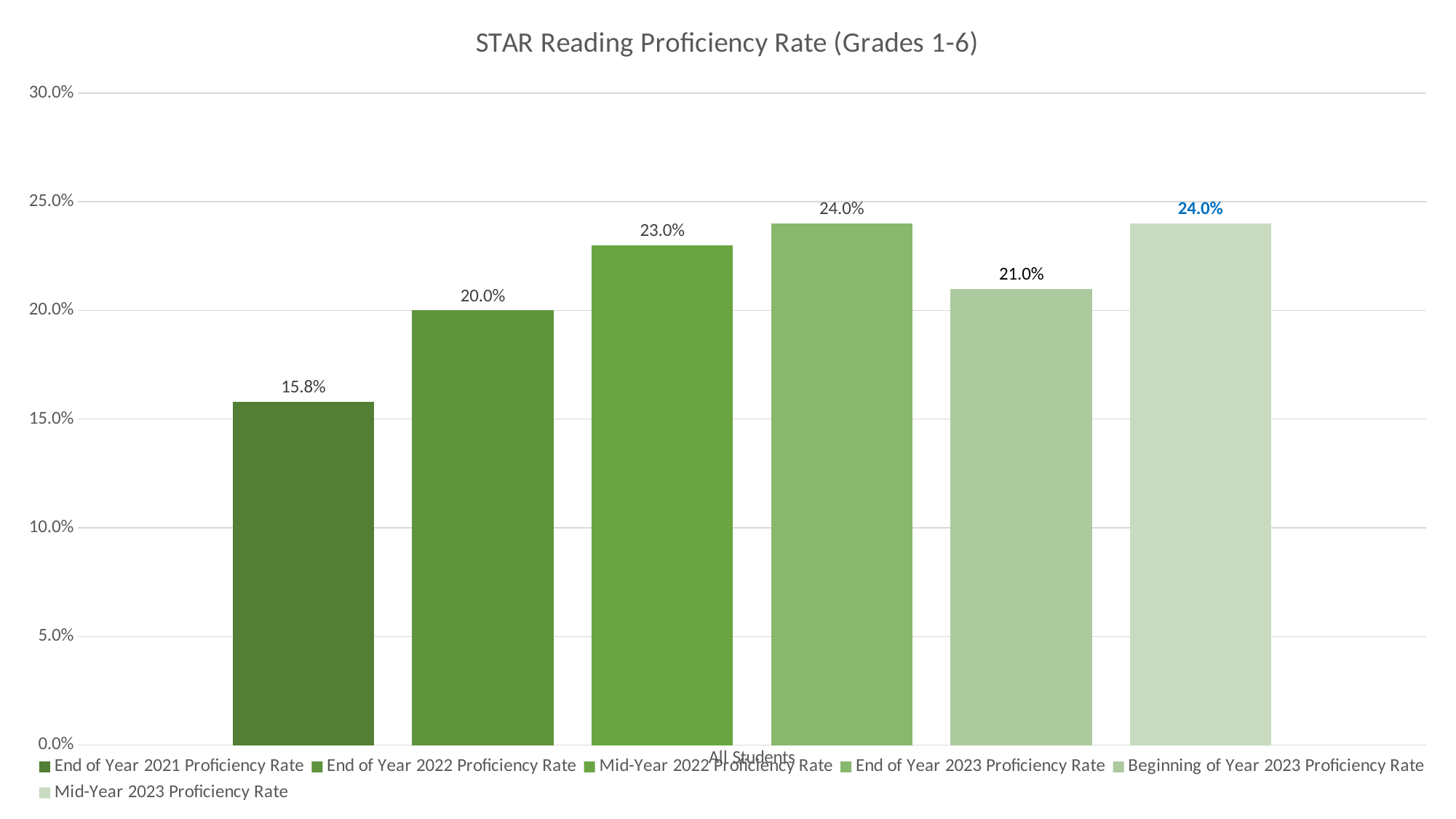
What is the Mid-Year 2022 Proficiency Rate shown on the chart? 23.0% What is the Mid-Year 2023 Proficiency Rate shown on the chart? 24.0% What is the Beginning of Year 2023 Proficiency Rate shown on the chart? 21.0% What is the End of Year 2021 Proficiency Rate shown on the chart? 15.8% How many series does the legend list? 6 What is the difference between the End of Year 2023 Proficiency Rate and the End of Year 2021 Proficiency Rate? 8.2% Which is larger, the End of Year 2022 Proficiency Rate or the Mid-Year 2022 Proficiency Rate? Mid-Year 2022 Proficiency Rate What is the title of the chart? STAR Reading Proficiency Rate (Grades 1-6) What is the difference between the Mid-Year 2023 Proficiency Rate and the Beginning of Year 2023 Proficiency Rate? 3.0% Which series has the lowest proficiency rate on the chart? End of Year 2021 Proficiency Rate Is the Beginning of Year 2023 Proficiency Rate greater or less than 25.0%? less What kind of chart is shown on the slide? bar chart